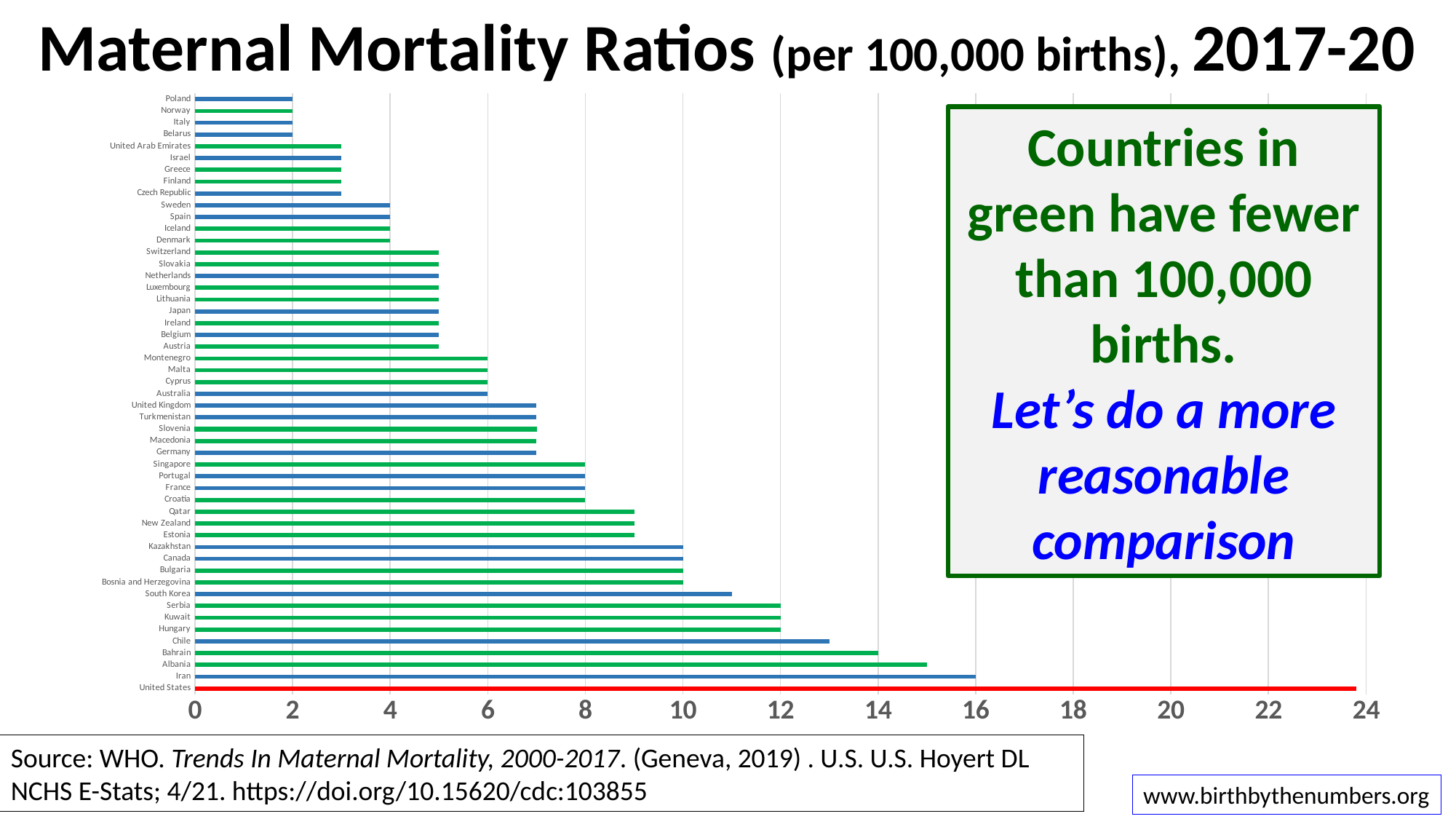
Which has a higher maternal mortality ratio, Albania or Bahrain? Albania Which country has the highest maternal mortality ratio in the chart? United States What kind of chart is shown on the slide? bar chart According to the text box, what do the green bars indicate? Countries with fewer than 100,000 births What is the maternal mortality ratio for Canada? 10 Is the value for South Korea greater or less than 12? less What is the maternal mortality ratio for Poland? 2 What colour is the bar for the United States? red What is the maternal mortality ratio for Iran? 16 Is the value for the United States greater or less than 22? greater